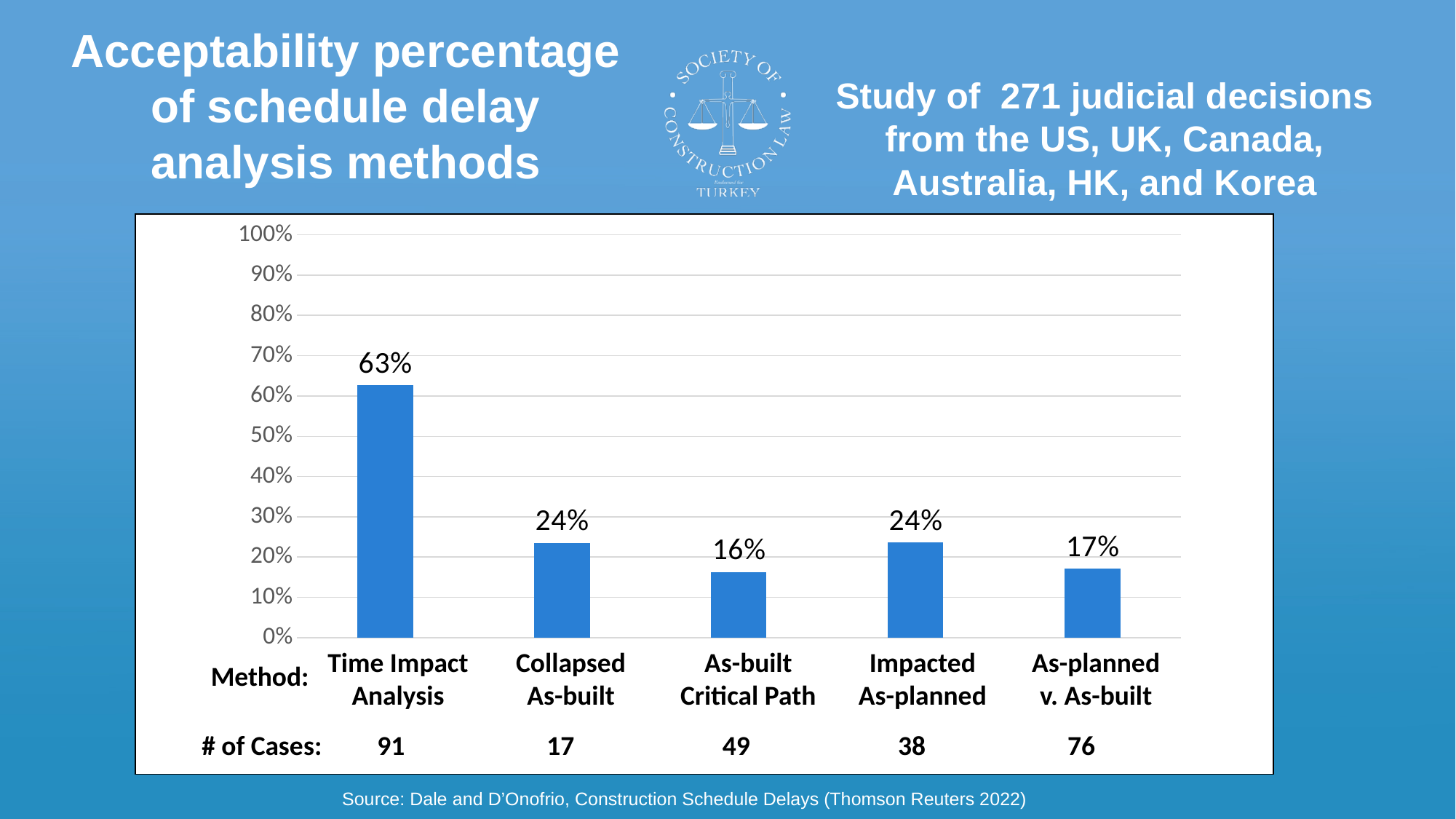
What is the difference in acceptability percentage between Time Impact Analysis and Collapsed As-built? 39% How many schedule delay analysis methods are shown in the chart? 5 What is the acceptability percentage for Time Impact Analysis? 63% What is the acceptability percentage for As-planned v. As-built? 17% What kind of chart is shown on the slide? bar chart Which has a higher acceptability percentage, Impacted As-planned or As-planned v. As-built? Impacted As-planned What is the acceptability percentage for As-built Critical Path? 16% Which method has the highest acceptability percentage? Time Impact Analysis What is the title of the chart on the slide? Acceptability percentage of schedule delay analysis methods Is the value for Time Impact Analysis greater or less than 50%? greater How many cases are listed for Collapsed As-built? 17 Which method has the lowest acceptability percentage? As-built Critical Path